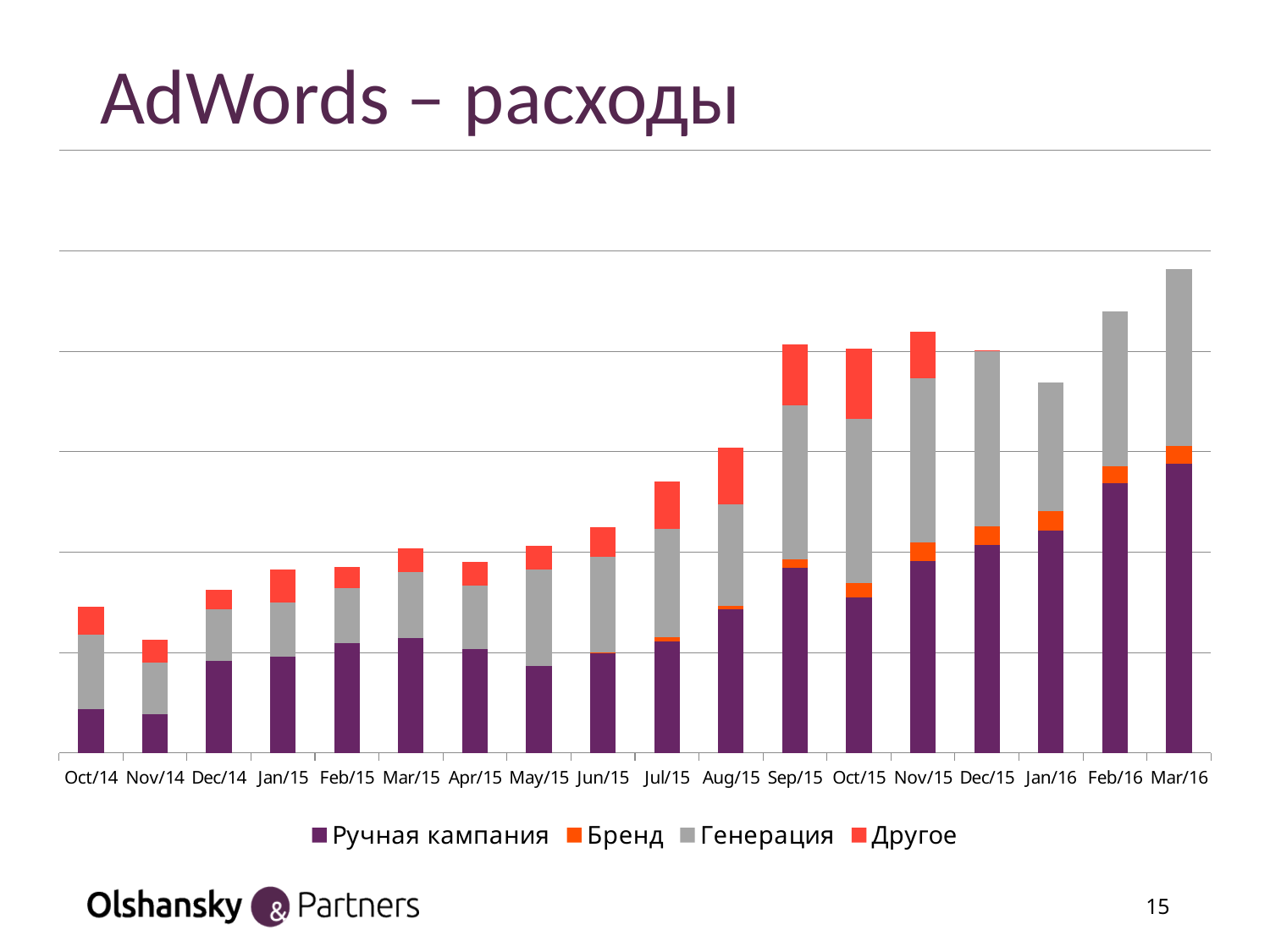
Which has the larger 'Ручная кампания' segment, Oct/14 or Mar/16? Mar/16 How many series does the chart's legend list? 4 Which series is shown in dark purple in the chart's legend? Ручная кампания Which month has the tallest stacked bar (highest total) in the chart? Mar/16 How many months (categories) are shown on the x axis of the chart? 18 What kind of chart is shown on the slide? Stacked bar chart Which month has the shortest stacked bar (lowest total) in the chart? Nov/14 Which has the larger total bar, Sep/15 or Jan/16? Sep/15 Which is the first month shown on the x axis of the chart? Oct/14 Do the total bar heights generally rise or fall from Oct/14 to Mar/16? Rise Which month has the largest 'Другое' segment in the chart? Oct/15 What is the title of the slide containing the chart? AdWords – расходы